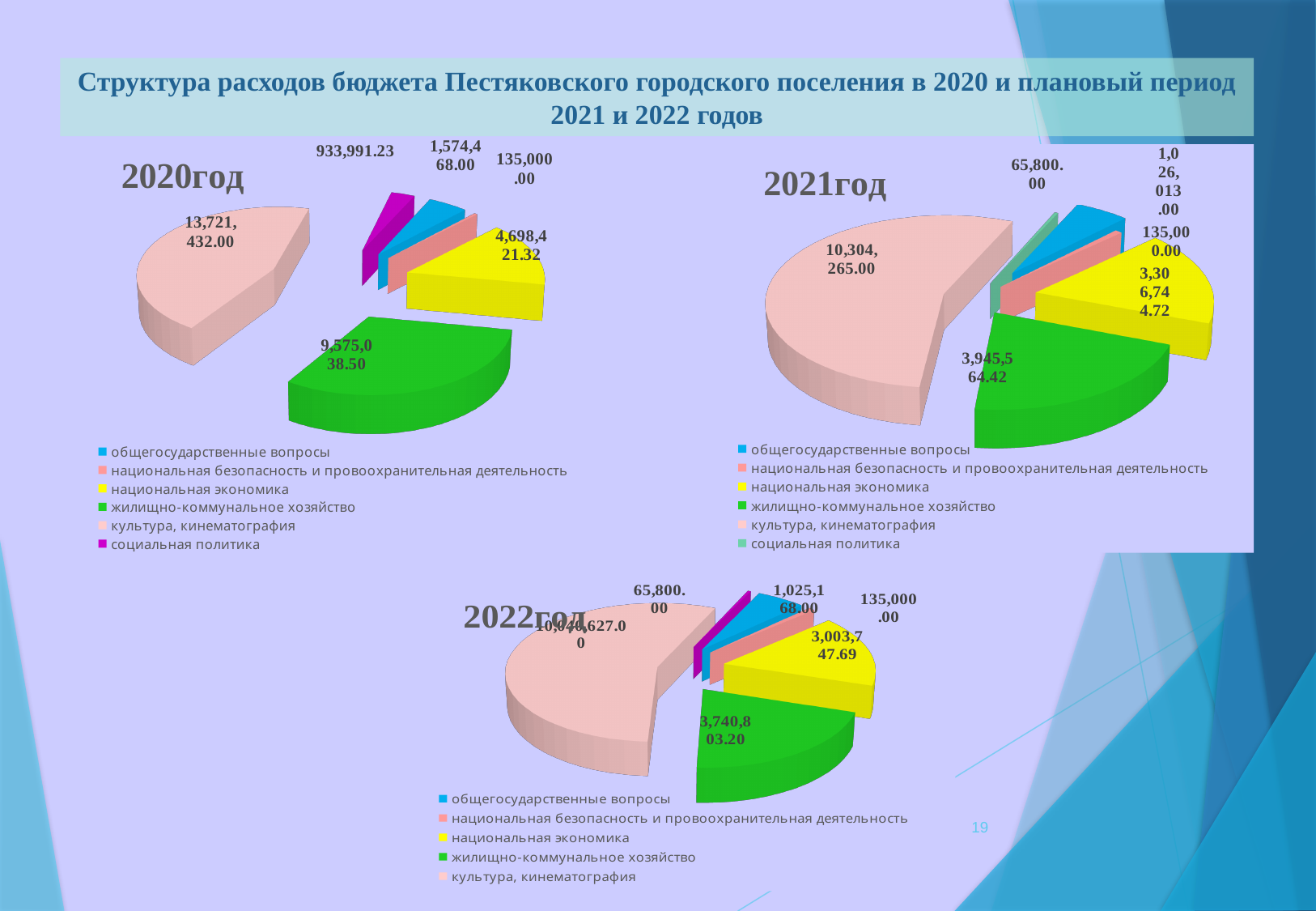
In the 2020год chart, which category has the largest slice? культура, кинематография In the 2021год chart, which is larger: жилищно-коммунальное хозяйство or национальная экономика? жилищно-коммунальное хозяйство In the 2021год chart, what is the difference between жилищно-коммунальное хозяйство and национальная экономика? 638,819.70 In the 2020год chart, what is the difference between жилищно-коммунальное хозяйство and национальная экономика? 4,876,617.18 In the 2022год chart, what is the value for национальная экономика? 3,003,747.69 What kind of chart is the 2020год chart? pie chart In the 2020год chart, what is the value for жилищно-коммунальное хозяйство? 9,575,038.50 How many entries does the legend of the 2020год chart list? 6 In the 2021год chart, which category has the smallest value? социальная политика In the 2021год chart, what is the value for культура, кинематография? 10,304,265.00 How many entries does the legend of the 2022год chart list? 5 In the 2020год chart, what is the value for национальная экономика? 4,698,421.32